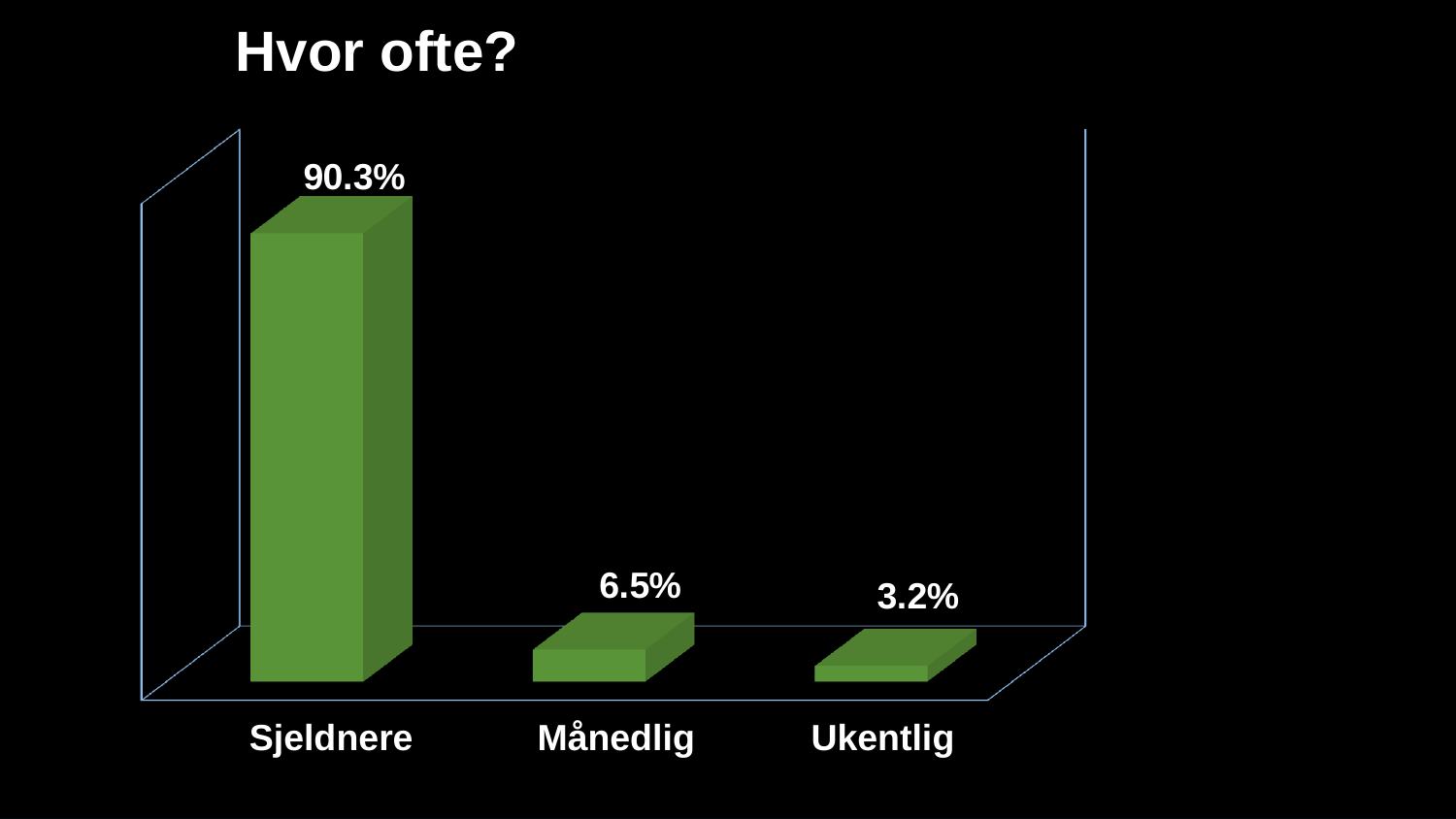
What is the difference between the values for Månedlig and Ukentlig? 3.3% What is the title of the chart? Hvor ofte? What is the value for Månedlig? 6.5% What is the difference between the values for Sjeldnere and Månedlig? 83.8% What kind of chart is shown on the slide? Bar chart How many categories are shown in the chart? 3 Which category has the highest value? Sjeldnere What is the value for Ukentlig? 3.2% Which is larger, the value for Månedlig or the value for Ukentlig? Månedlig Do the values rise or fall from left to right along the x axis? Fall Which category has the lowest value? Ukentlig What is the value for Sjeldnere? 90.3%